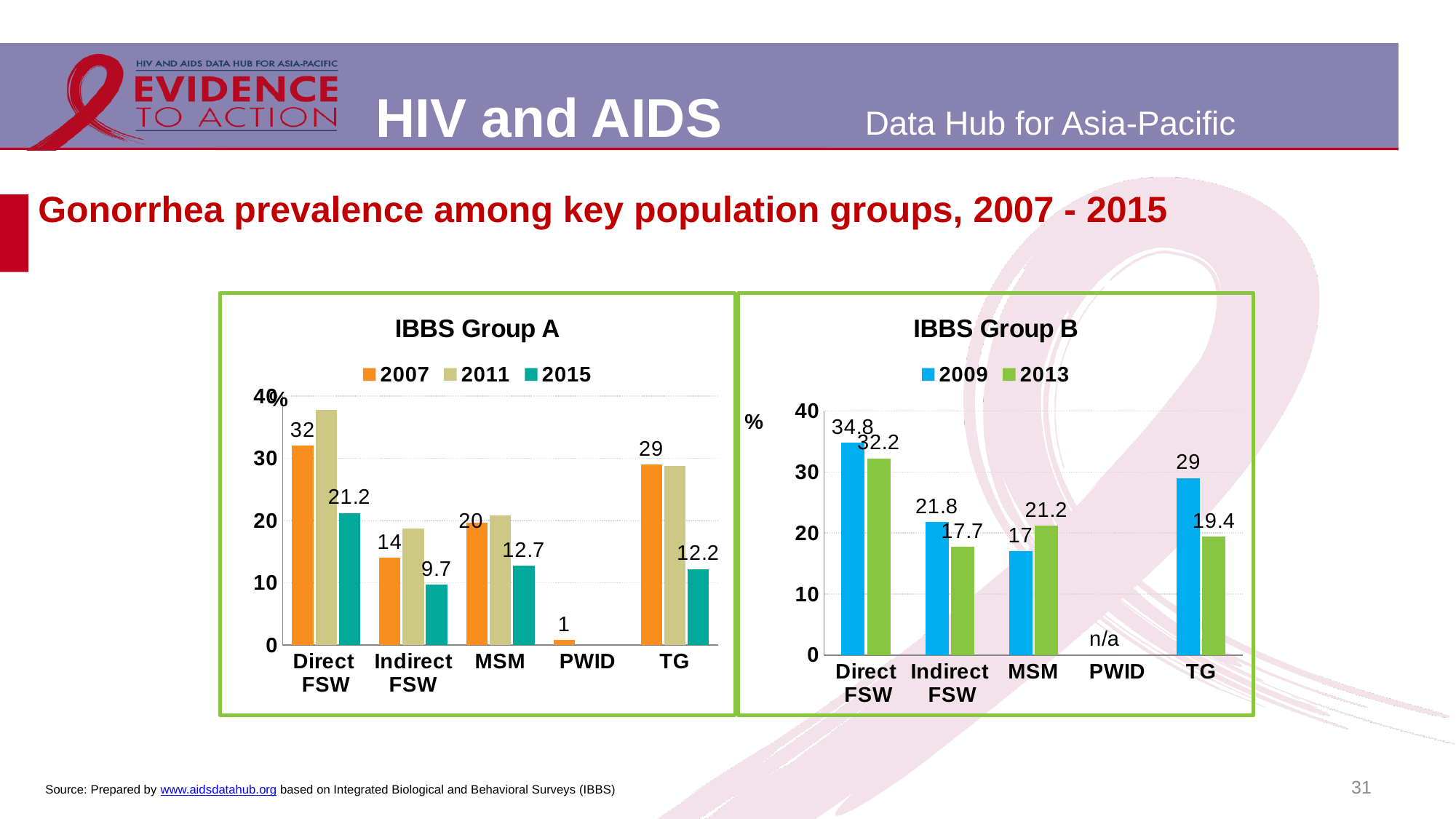
In the IBBS Group B chart, which population group has the highest 2009 value? Direct FSW How many series does the legend of the IBBS Group A chart list? 3 In the IBBS Group A chart, what is the 2007 value for Direct FSW? 32 What kind of chart is the IBBS Group B chart? bar chart In the IBBS Group B chart, what is the difference between the 2009 and 2013 values for Direct FSW? 2.6 In the IBBS Group B chart, what is the 2013 value for MSM? 21.2 In the IBBS Group A chart, which population group has the lowest 2007 value? PWID In the IBBS Group B chart, which is larger for MSM: the 2009 value or the 2013 value? 2013 In the IBBS Group A chart, is the 2011 value for Direct FSW greater or less than 30? greater In the IBBS Group B chart, what is the 2009 value for Direct FSW? 34.8 In the IBBS Group A chart, what is the 2015 value for TG? 12.2 In the IBBS Group A chart, what is the difference between the 2007 and 2015 values for Direct FSW? 10.8